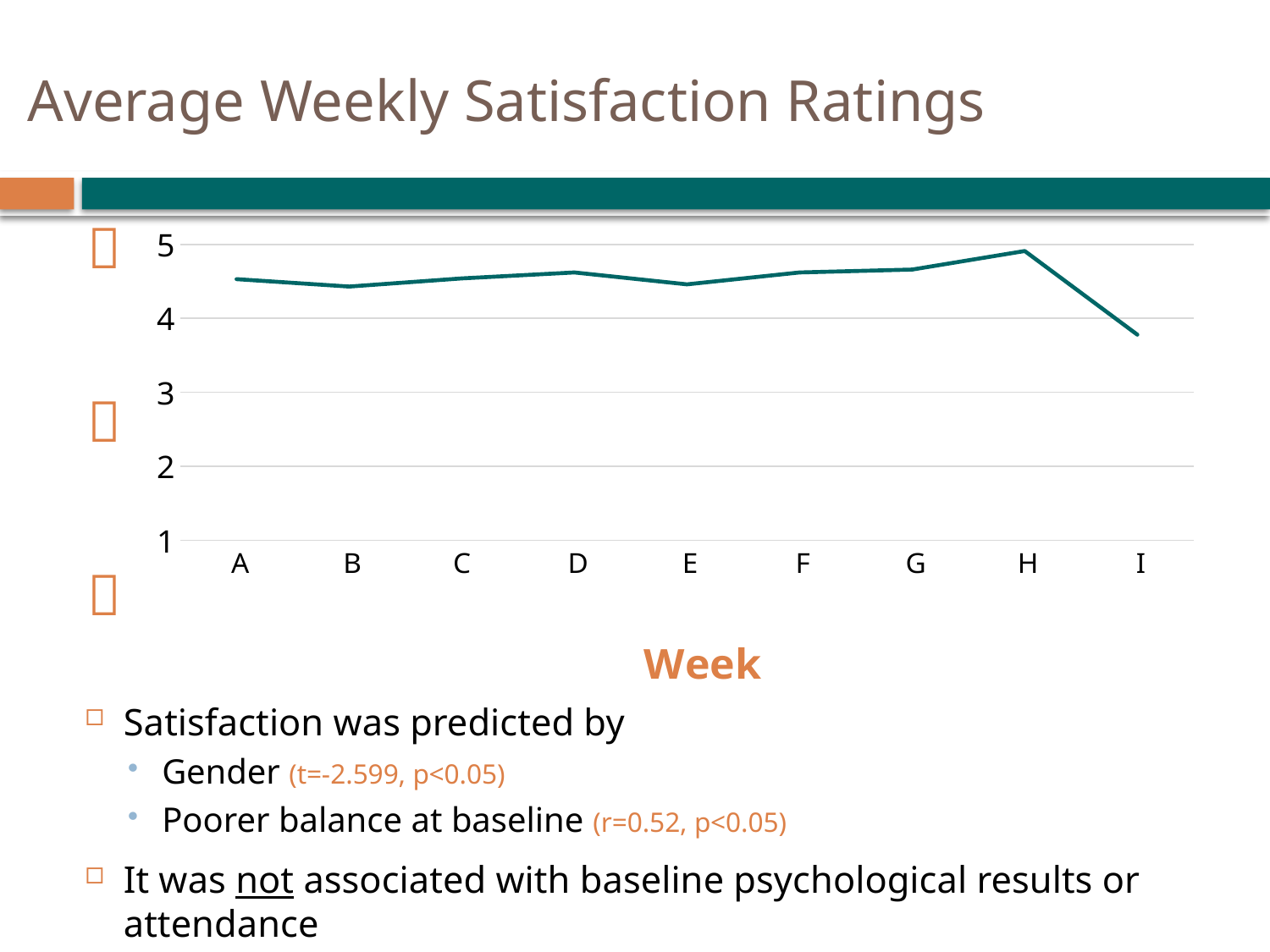
What is the highest value shown on the y axis of the chart? 5 Does the satisfaction rating rise or fall from week H to week I? fall Is the value for week H greater or less than 4? greater What is the label of the x axis of the chart? Week Which week has the highest average satisfaction rating? H What kind of chart is shown on the slide? line chart Which week has a higher satisfaction rating, H or I? H Is the value for week A greater or less than 3? greater Which week has a higher satisfaction rating, B or H? H Is the value for week I greater or less than 4? less Which week has the lowest average satisfaction rating? I How many weeks are plotted along the x axis of the chart? 9